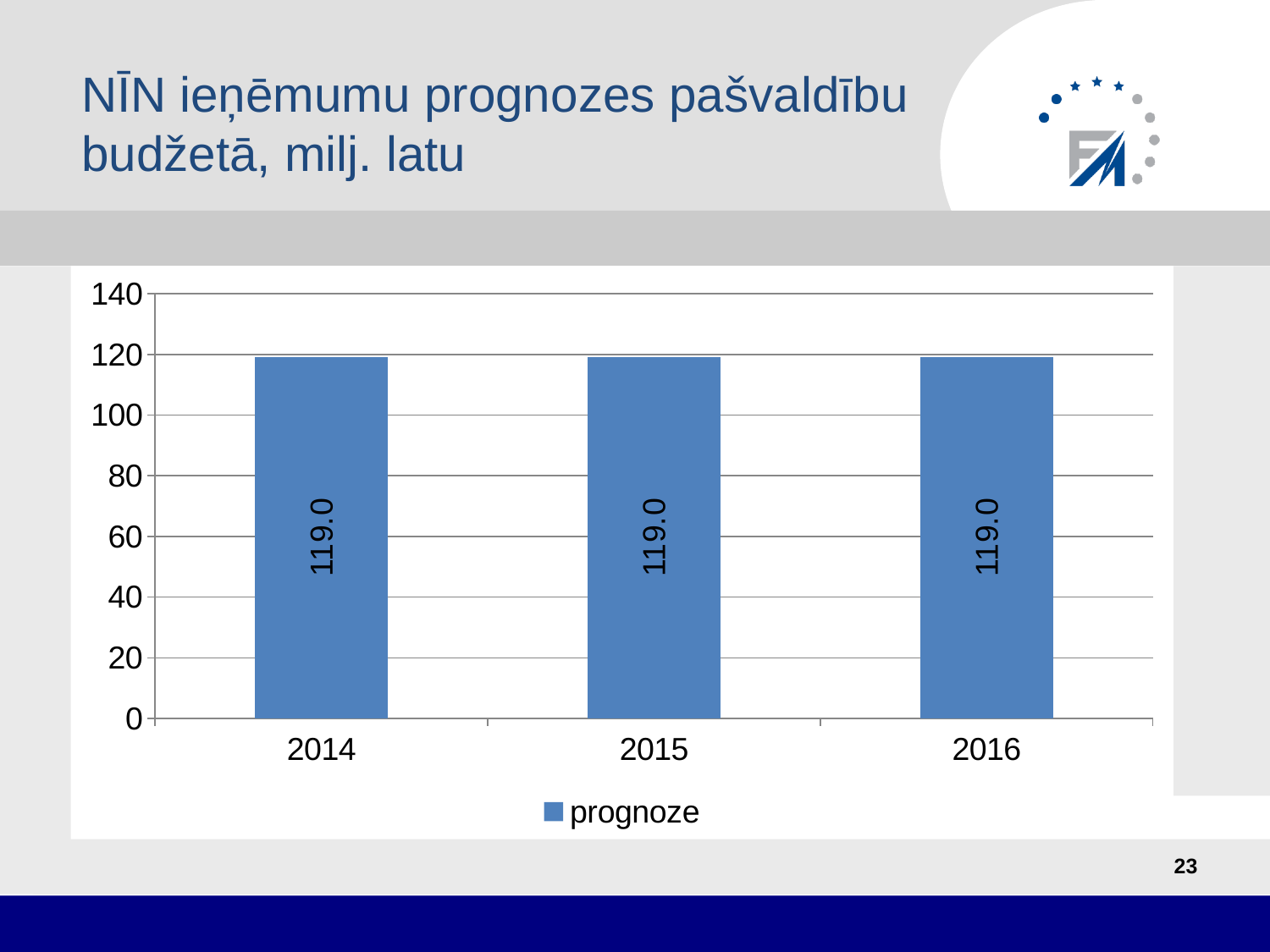
What is the value for 2016? 119.0 What kind of chart is shown on the slide? bar chart How many years are shown on the x axis? 3 What is the value for 2015? 119.0 Do the values rise, fall or stay the same from 2014 to 2016? stay the same What is the name of the series in the legend? prognoze What is the title of the slide? NĪN ieņēmumu prognozes pašvaldību budžetā, milj. latu Is the value for 2015 greater or less than 100? greater What is the difference between the values for 2014 and 2016? 0.0 How many series does the legend list? 1 What is the value for 2014? 119.0 Is the value for 2016 greater or less than 120? less